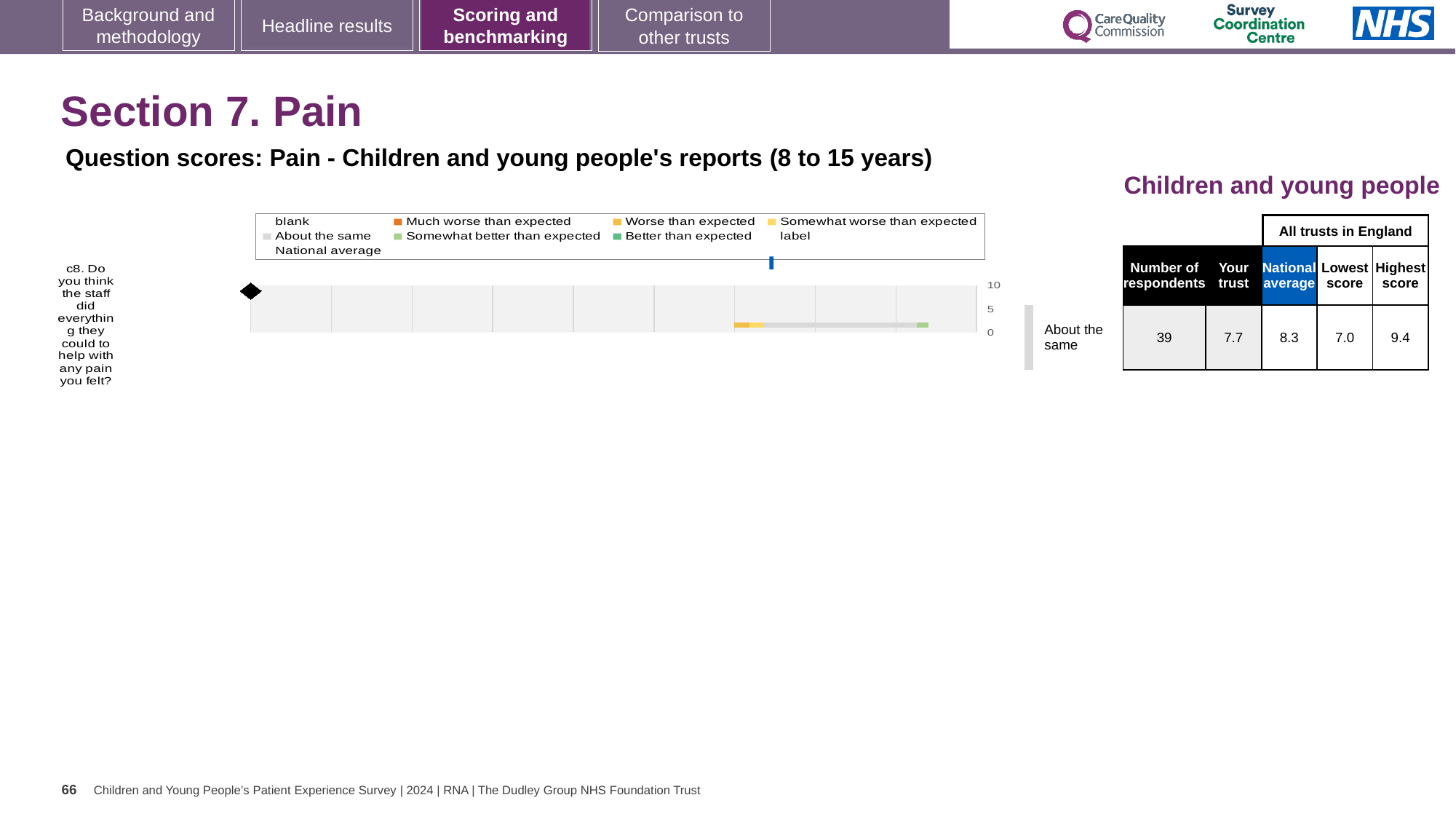
In the table beside the chart, what is the national average score for question c8? 8.3 What is the difference between the highest score (9.4) and the lowest score (7.0) for question c8? 2.4 What benchmark rating is shown for question c8 next to the chart? About the same How many questions (categories) are plotted in the chart? 1 What colour is used in the legend for 'Better than expected'? green In the table beside the chart, what is the lowest score among all trusts in England for question c8? 7.0 What kind of chart is shown on the slide? bar chart In the table beside the chart, what is the 'Your trust' score for question c8? 7.7 In the table beside the chart, how many respondents answered question c8? 39 In the table beside the chart, what is the highest score among all trusts in England for question c8? 9.4 Which question is plotted in the chart? c8. Do you think the staff did everything they could to help with any pain you felt? Which is larger for question c8: the 'Your trust' score or the national average? National average